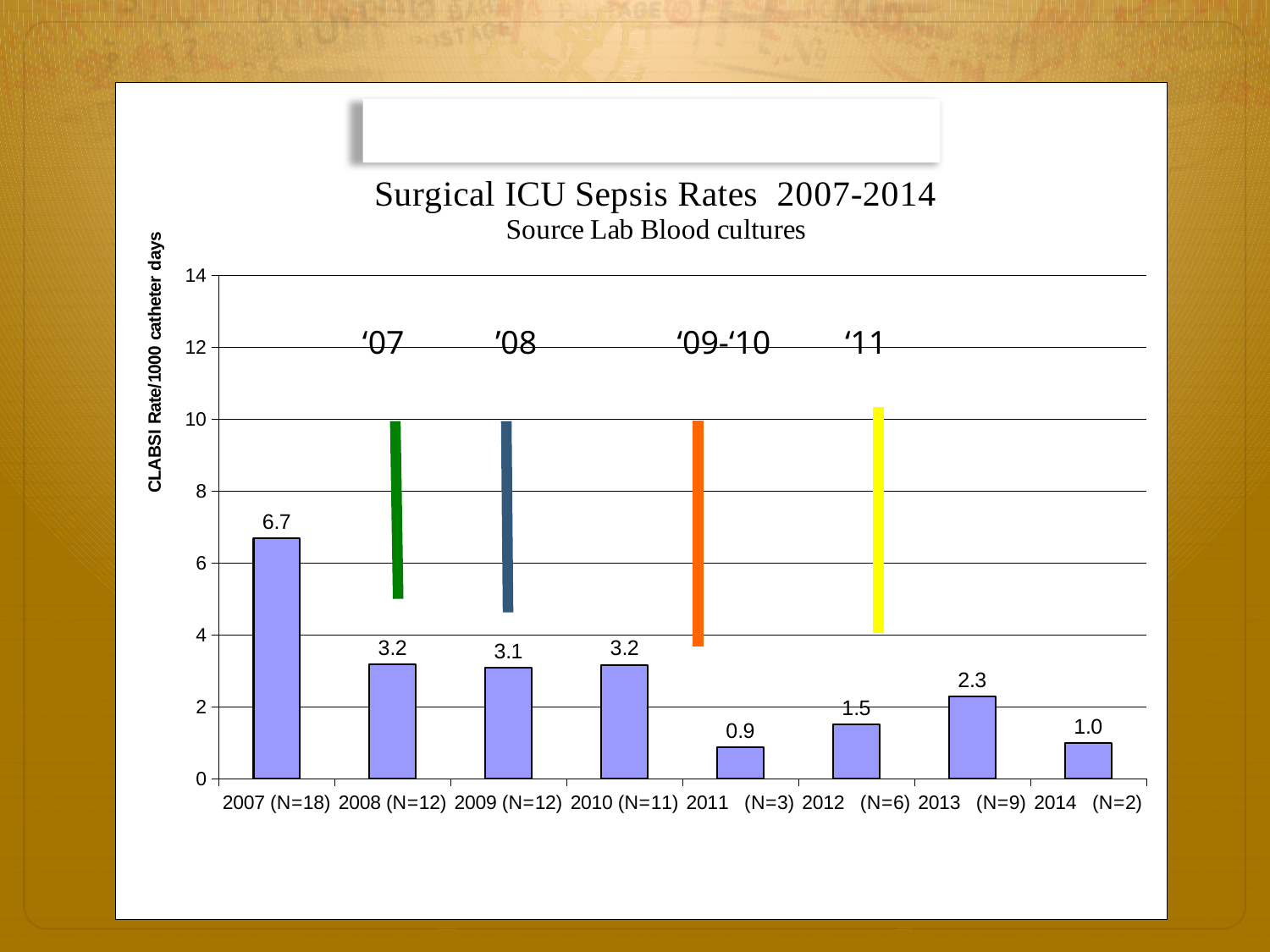
What is the CLABSI rate for 2014 (N=2)? 1.0 What is the label of the y axis? CLABSI Rate/1000 catheter days What is the difference between the CLABSI rate in 2007 and in 2008? 3.5 What is the CLABSI rate for 2011 (N=3)? 0.9 Which is larger, the CLABSI rate for 2012 or for 2013? 2013 Which year has the highest CLABSI rate? 2007 (N=18) What is the CLABSI rate for 2007 (N=18)? 6.7 What kind of chart is shown on the slide? bar chart What is the CLABSI rate for 2013 (N=9)? 2.3 Is the value for 2007 greater or less than 6? greater How many years are plotted on the x axis? 8 Which year has the lowest CLABSI rate? 2011 (N=3)